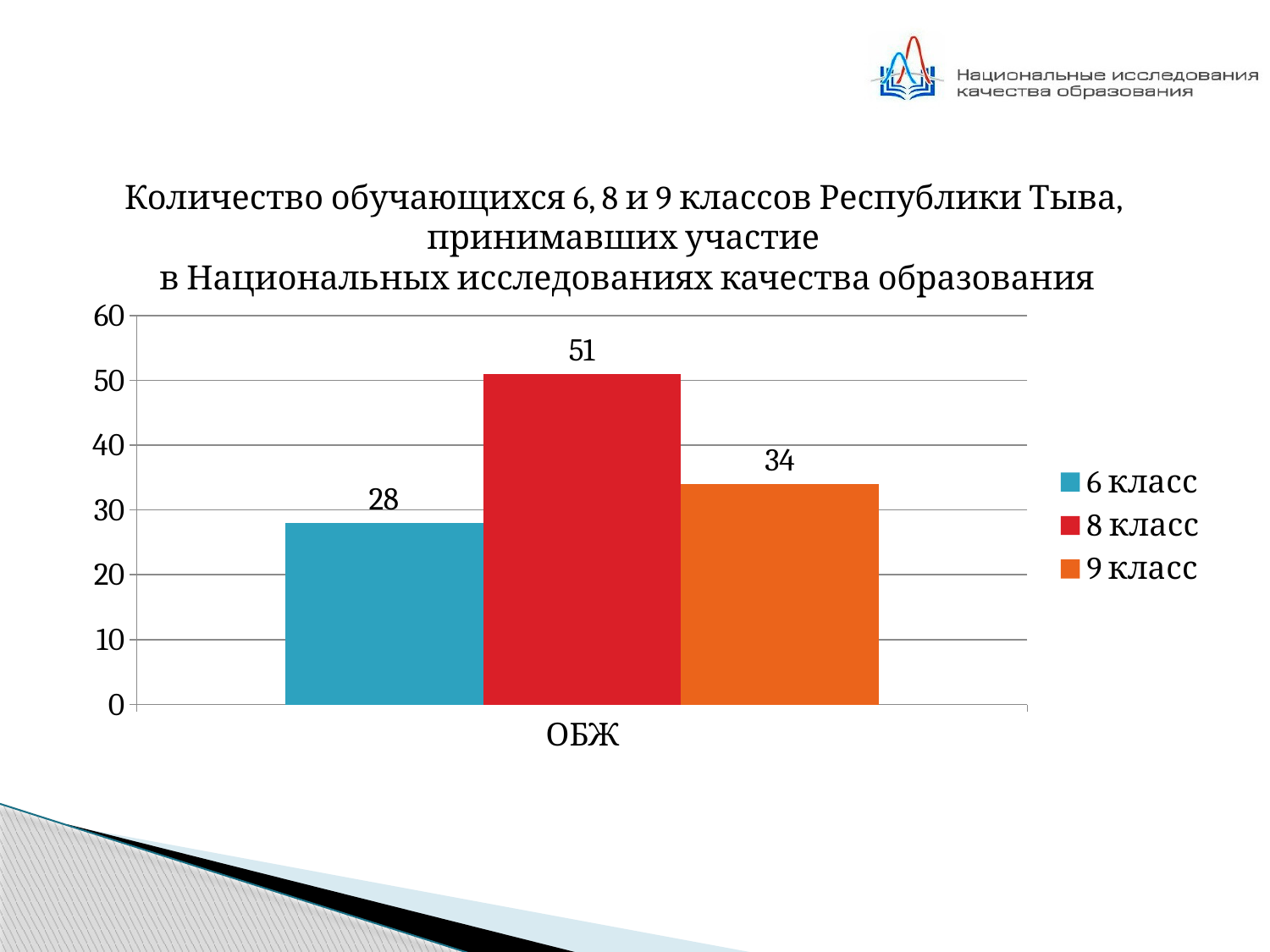
Which series has the highest value? 8 класс What is the value for 6 класс in the ОБЖ category? 28 What is the value for 9 класс in the ОБЖ category? 34 What is the value for 8 класс in the ОБЖ category? 51 What is the difference between the values for 8 класс and 6 класс? 23 How many series does the legend list? 3 What is the difference between the values for 9 класс and 6 класс? 6 What kind of chart is shown on the slide? bar chart Which series has the lowest value? 6 класс Which is larger, the value for 9 класс or the value for 6 класс? 9 класс Is the value for 8 класс greater or less than 50? greater What is the category label on the x axis? ОБЖ